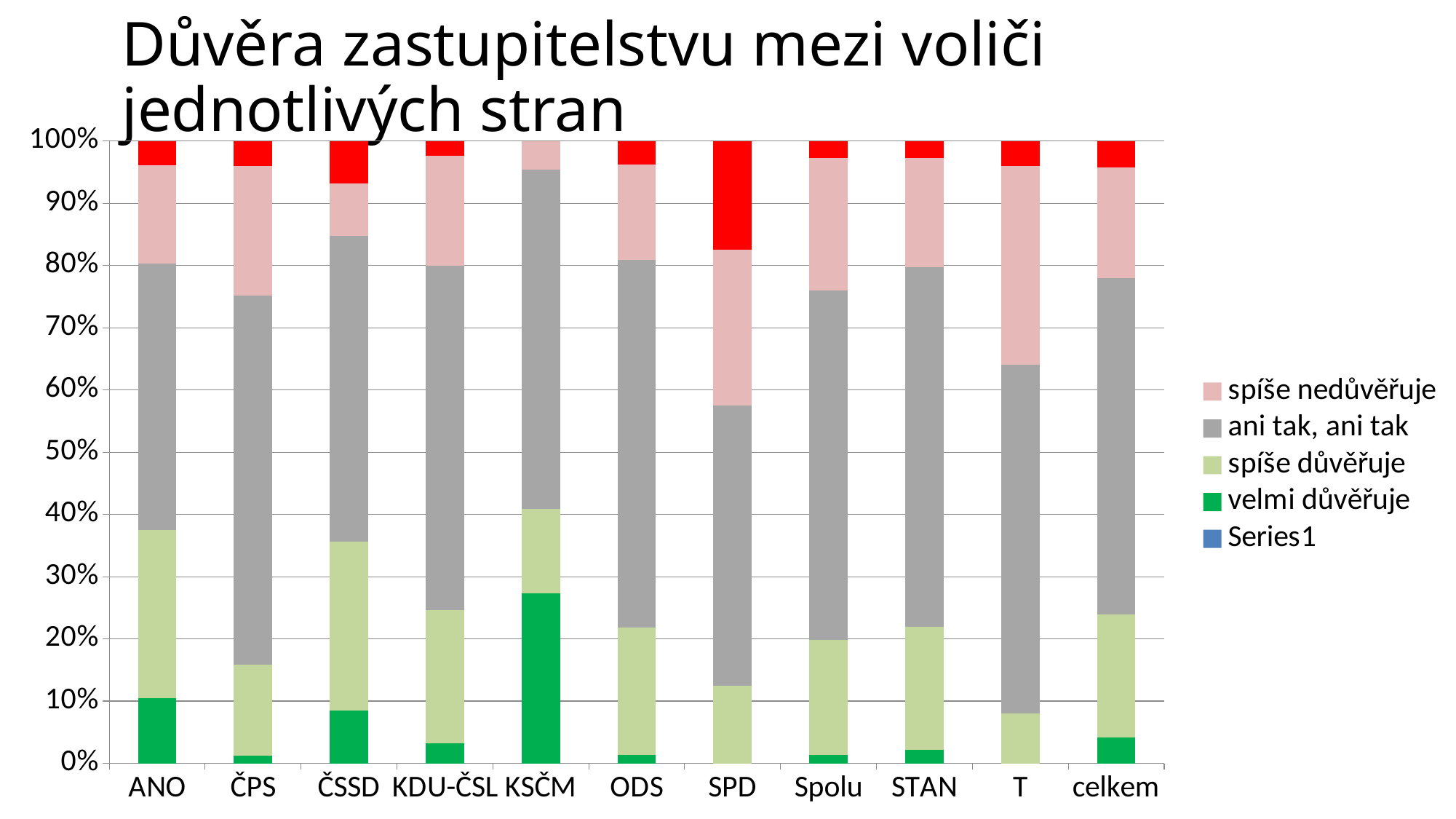
Is the 'velmi důvěřuje' value for ANO greater or less than 20%? less How many series does the legend list? 5 What kind of chart is shown on the slide? stacked bar chart Which has a larger 'velmi důvěřuje' segment, KSČM or ANO? KSČM How many categories (parties) are shown along the x axis? 11 Is the 'velmi důvěřuje' value for KSČM greater or less than 20%? greater Which colour represents 'ani tak, ani tak' in the legend? grey What is the title of the chart? Důvěra zastupitelstvu mezi voliči jednotlivých stran Which category has the largest 'spíše nedůvěřuje' segment? T Is the combined 'velmi důvěřuje' and 'spíše důvěřuje' share for ANO greater or less than 30%? greater Which category has the largest 'velmi důvěřuje' segment? KSČM